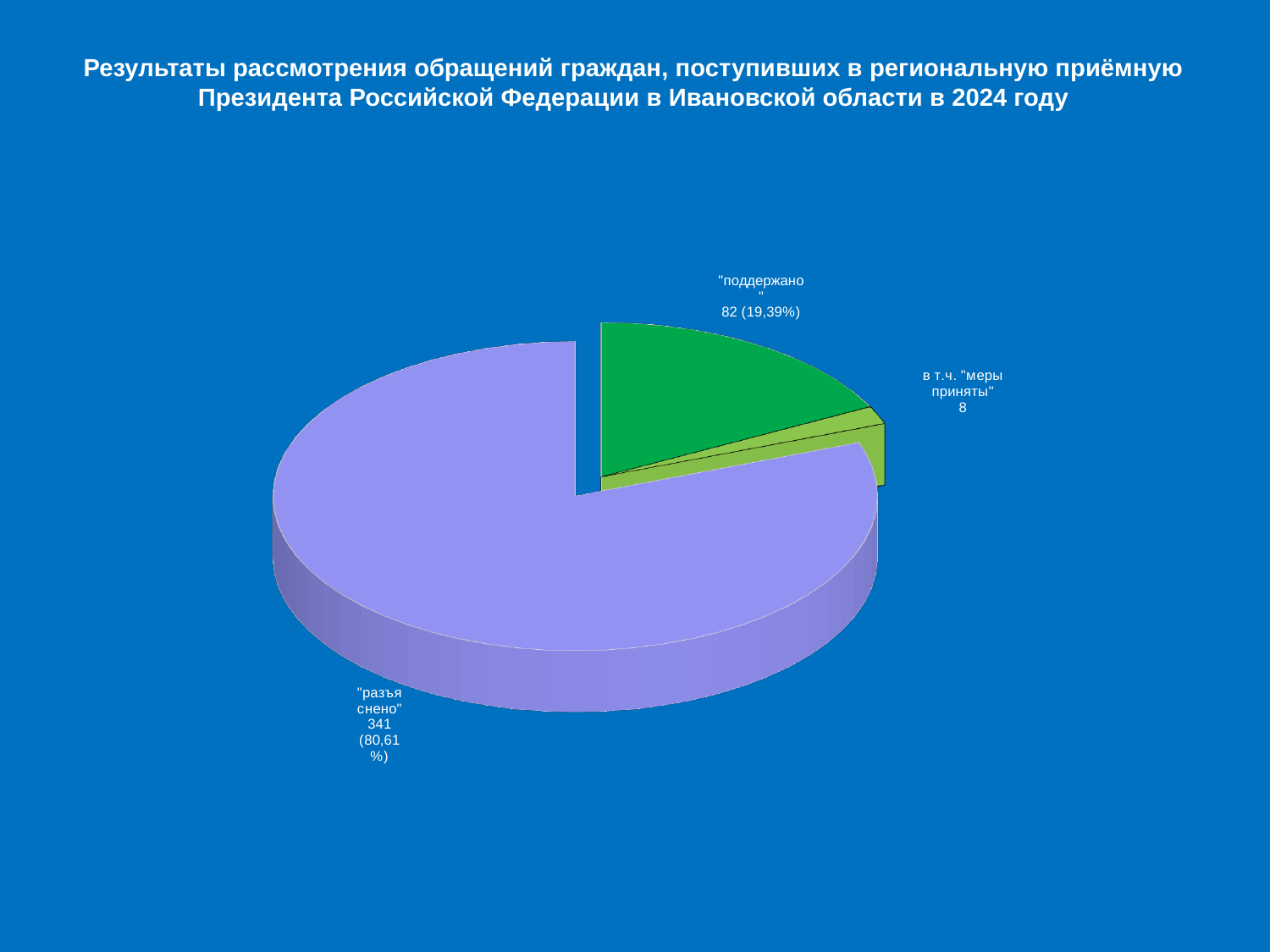
Which slice of the pie chart is the smallest? в т.ч. "меры приняты" How many appeals are labelled "разъяснено" on the pie chart? 341 What percentage share does the "поддержано" slice have? 19,39% How many slices does the pie chart have? 3 Which is larger, the "поддержано" value or the "в т.ч. "меры приняты"" value? "поддержано" What kind of chart is shown on the slide? pie chart What year does the chart title say the appeals were received in? 2024 Which slice of the pie chart is the largest? "разъяснено" What is the difference between the "разъяснено" count and the "поддержано" count? 259 What value is shown for the slice "в т.ч. "меры приняты""? 8 How many appeals are labelled "поддержано" on the pie chart? 82 What percentage share does the "разъяснено" slice have? 80,61%